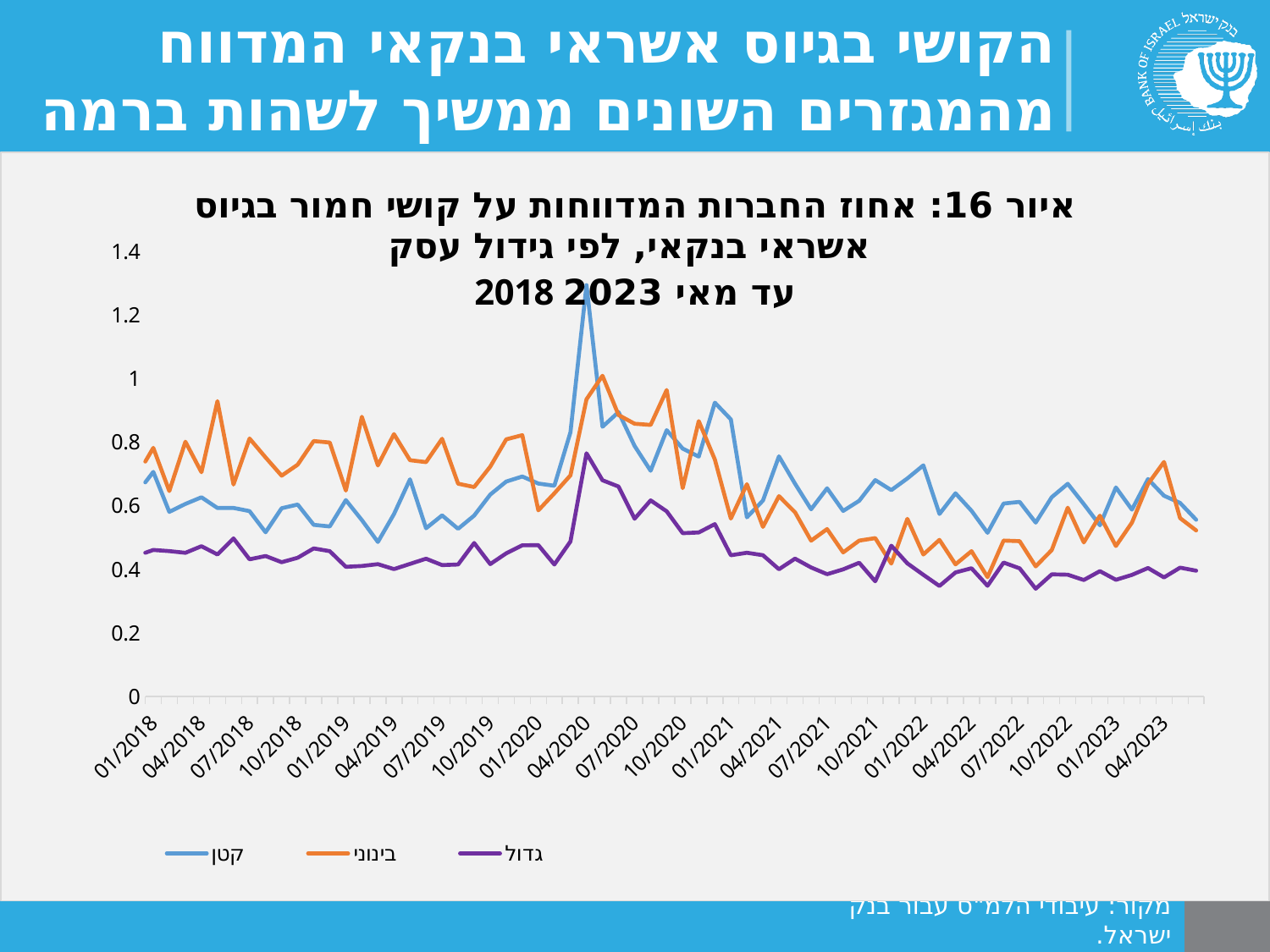
At 01/2018, which series has the larger value, בינוני or גדול? בינוני Which series reaches the highest value anywhere on the chart? קטן Which series does the orange line represent? בינוני Is the value of the גדול series at 01/2018 greater or less than 0.6? less Does the גדול series generally rise or fall from 04/2020 to 04/2023? fall What is the highest value shown on the vertical axis? 1.4 Which series is the lowest at 04/2023? גדול Which series does the purple line represent? גדול What kind of chart is shown on the slide? line chart How many series does the legend list? 3 Is the value of the בינוני series at 01/2018 greater or less than 0.6? greater Is the peak value of the קטן series in 2020 greater or less than 1.2? greater